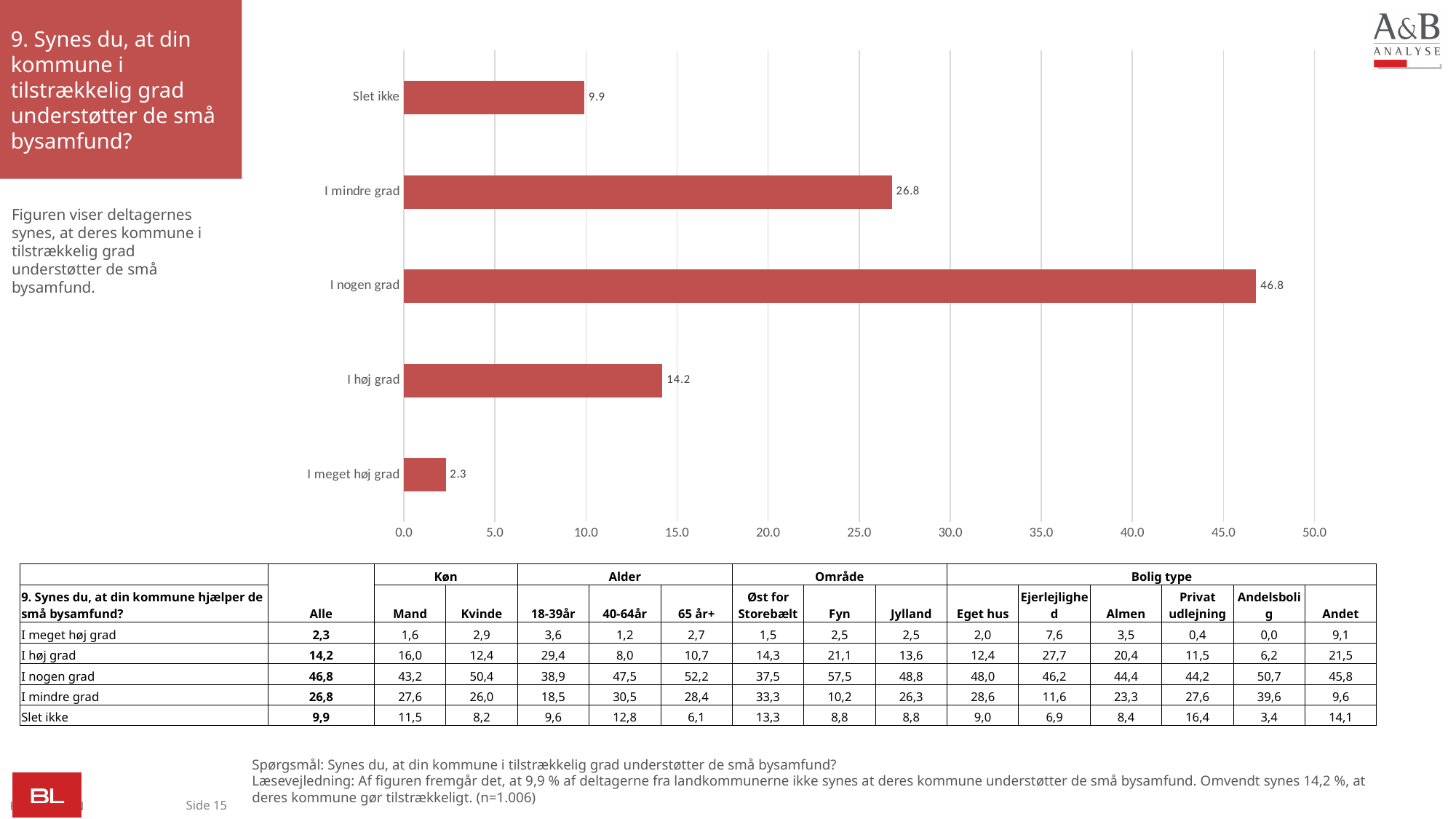
Is the value for "I nogen grad" greater or less than 45.0? greater What is the highest value shown on the x axis? 50.0 What is the value for "Slet ikke"? 9.9 What is the value for "I mindre grad"? 26.8 How many categories are shown in the chart? 5 What is the value for "I meget høj grad"? 2.3 Which is larger, the value for "I høj grad" or the value for "Slet ikke"? I høj grad What kind of chart is shown on the slide? Bar chart What is the difference between the values for "I mindre grad" and "I høj grad"? 12.6 What is the value for "I nogen grad"? 46.8 Which category has the lowest value? I meget høj grad Which category has the highest value? I nogen grad